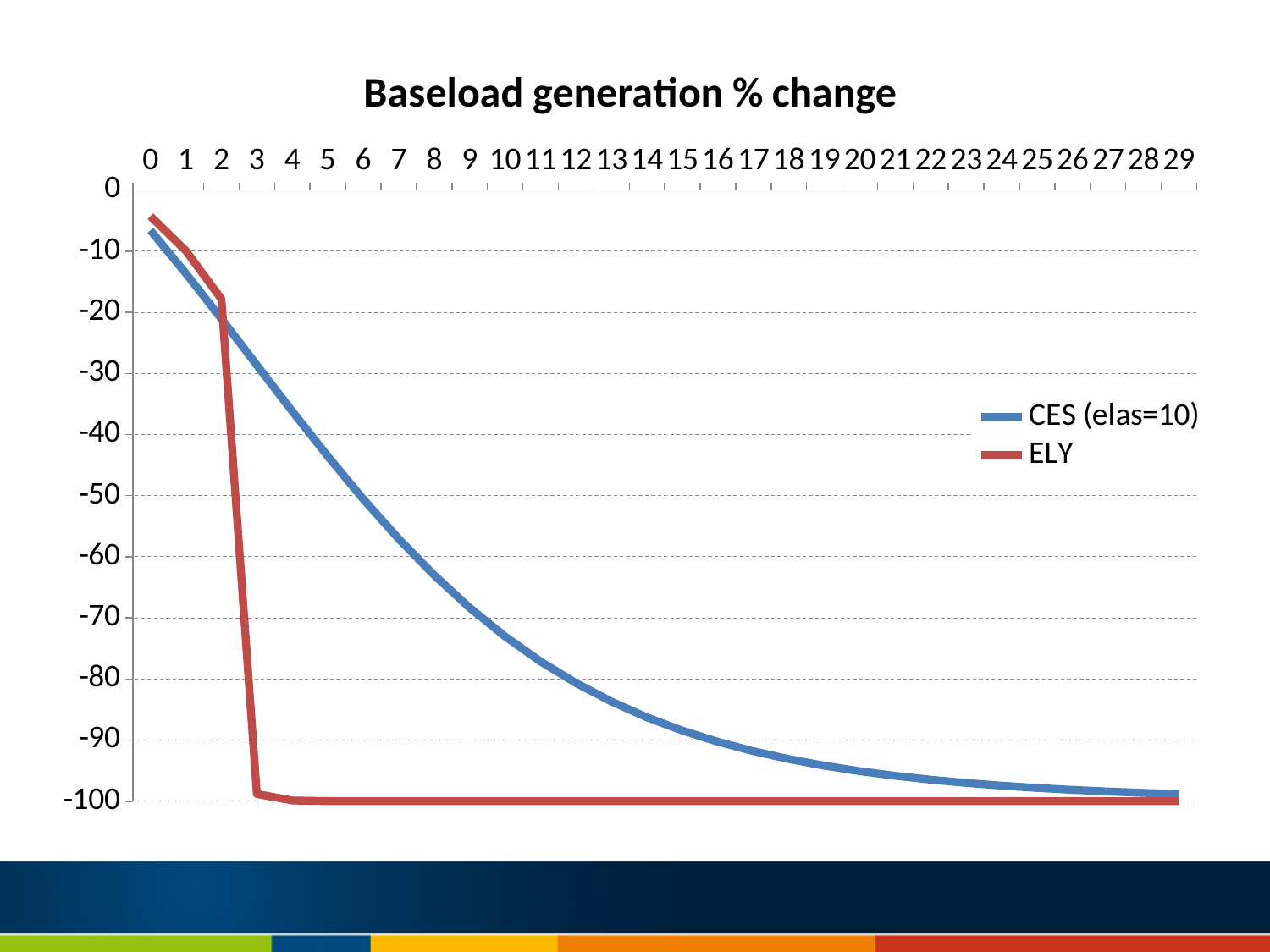
How many points are labelled along the x axis? 30 How many series does the legend list? 2 What are the two series named in the legend? CES (elas=10) and ELY Do the values of the CES (elas=10) series rise or fall as x increases? fall Is the value for ELY at x=0 greater or less than -10? greater Do the values of the ELY series rise or fall as x increases from 0 to 4? fall Is the value for ELY at x=3 greater or less than -90? less Is the value for CES (elas=10) at x=20 greater or less than -90? less At x=10, which series has the higher value, CES (elas=10) or ELY? CES (elas=10) What kind of chart is shown on the slide? line chart What is the title of the chart? Baseload generation % change